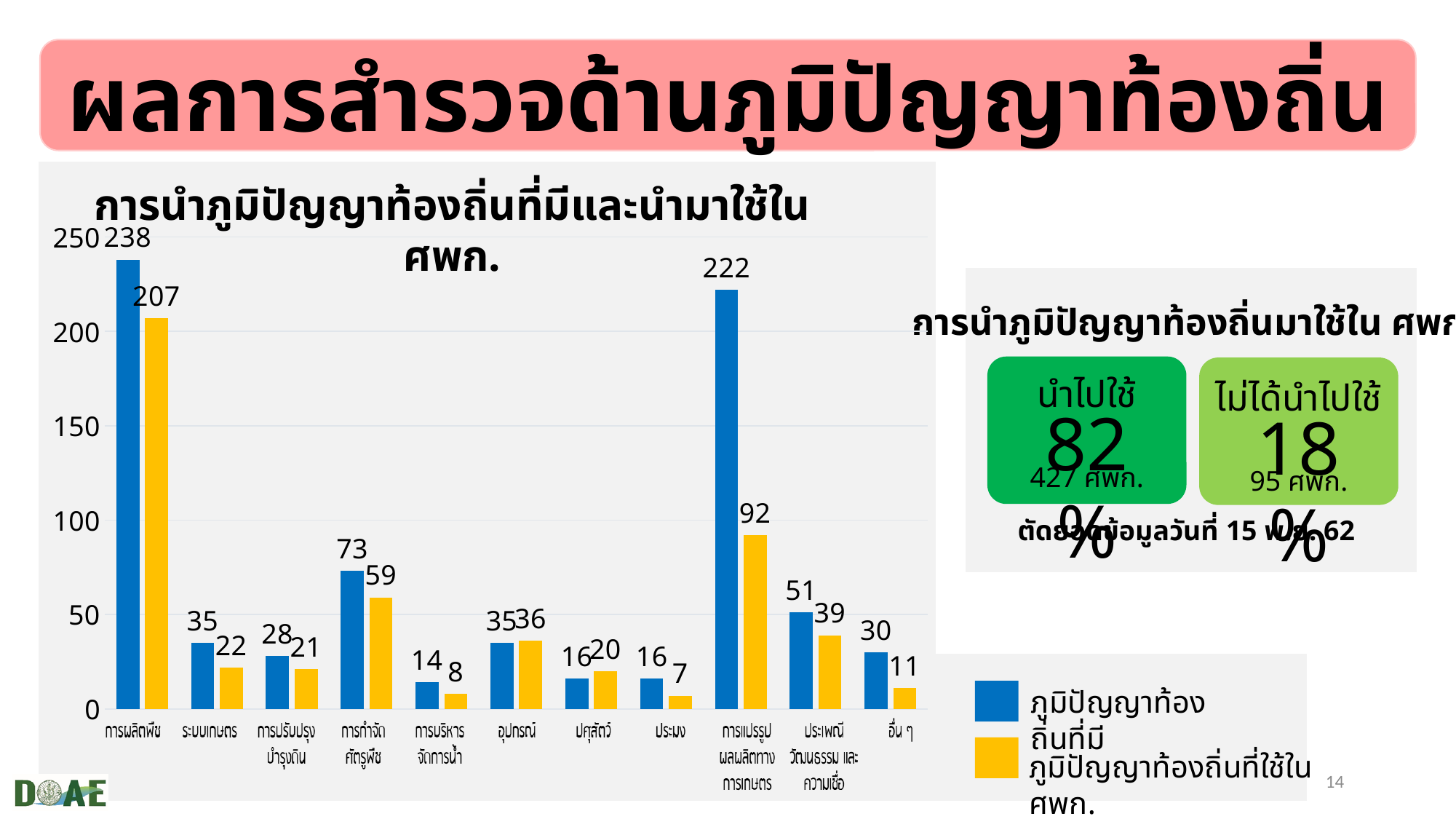
What is the value of ภูมิปัญญาท้องถิ่นที่ใช้ใน ศพก. for ประมง? 7 How many series does the chart legend list? 2 What colour are the bars for ภูมิปัญญาท้องถิ่นที่ใช้ใน ศพก.? yellow Which is larger for การกำจัดศัตรูพืช: ภูมิปัญญาท้องถิ่นที่มี or ภูมิปัญญาท้องถิ่นที่ใช้ใน ศพก.? ภูมิปัญญาท้องถิ่นที่มี What is the difference between ภูมิปัญญาท้องถิ่นที่มี and ภูมิปัญญาท้องถิ่นที่ใช้ใน ศพก. for การแปรรูปผลผลิตทางการเกษตร? 130 Is the value of ภูมิปัญญาท้องถิ่นที่มี for ประเพณี วัฒนธรรม และความเชื่อ greater or less than 100? less How many categories are shown on the x axis of the chart? 11 What is the value of ภูมิปัญญาท้องถิ่นที่มี for การผลิตพืช? 238 What is the value of ภูมิปัญญาท้องถิ่นที่ใช้ใน ศพก. for การแปรรูปผลผลิตทางการเกษตร? 92 Which category has the lowest value for ภูมิปัญญาท้องถิ่นที่ใช้ใน ศพก.? ประมง What type of chart is shown on the slide? bar chart Which category has the highest value for ภูมิปัญญาท้องถิ่นที่มี? การผลิตพืช